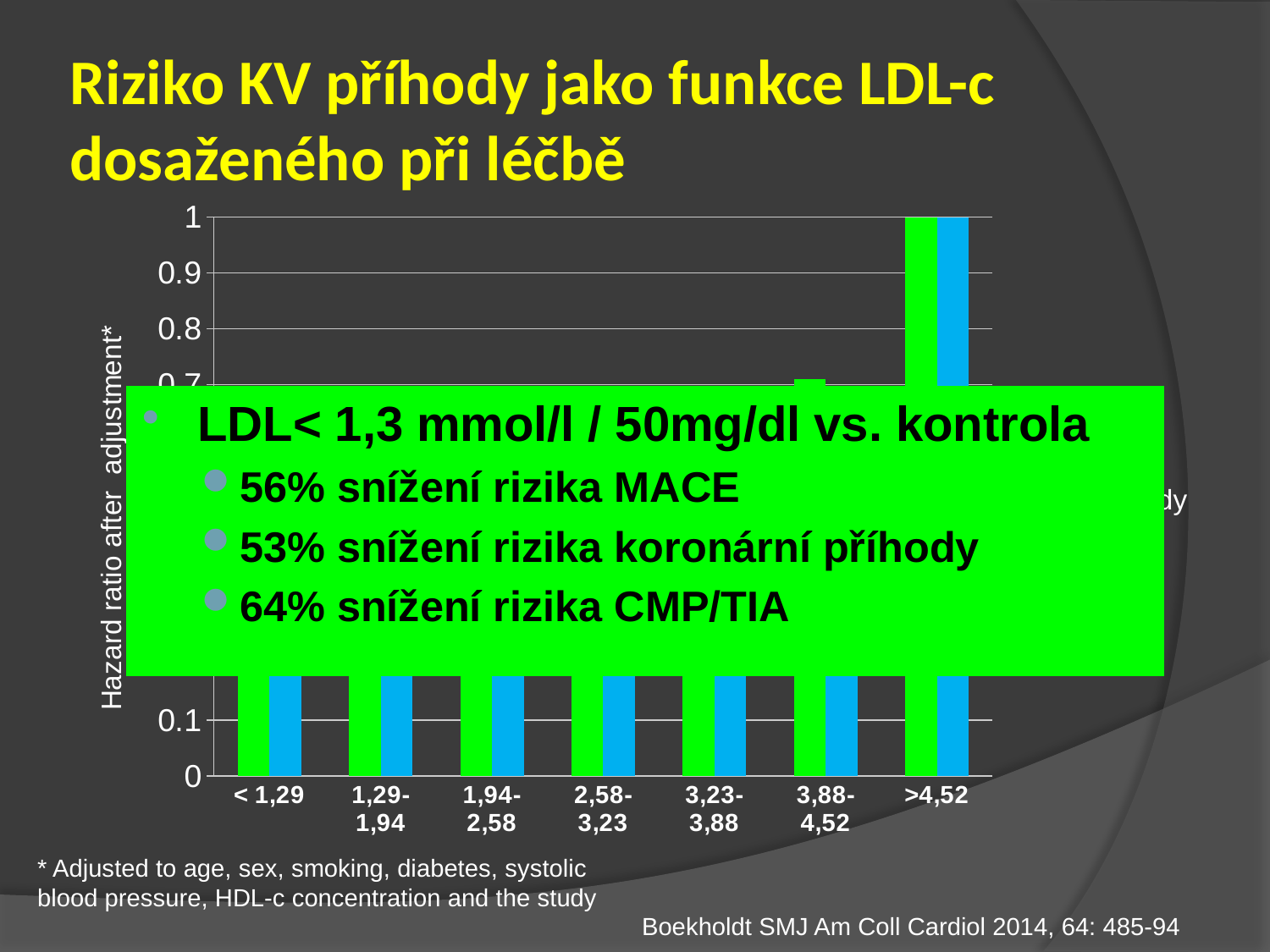
Is the green bar for the 3,88-4,52 category greater or less than 0.5? greater Which category has the highest hazard ratio in the chart? >4,52 What kind of chart is shown on the slide? bar chart What is the label of the y axis of the chart? Hazard ratio after adjustment* What is the hazard ratio for the >4,52 category in the chart? 1 What is the label of the first category on the x axis of the chart? < 1,29 How many LDL-c categories are shown on the x axis of the chart? 7 Which category has a larger hazard ratio, >4,52 or < 1,29? >4,52 Is the hazard ratio for the < 1,29 category greater or less than 0.8? less What is the highest tick value shown on the y axis of the chart? 1 Is the hazard ratio for the >4,52 category greater or less than 0.5? greater